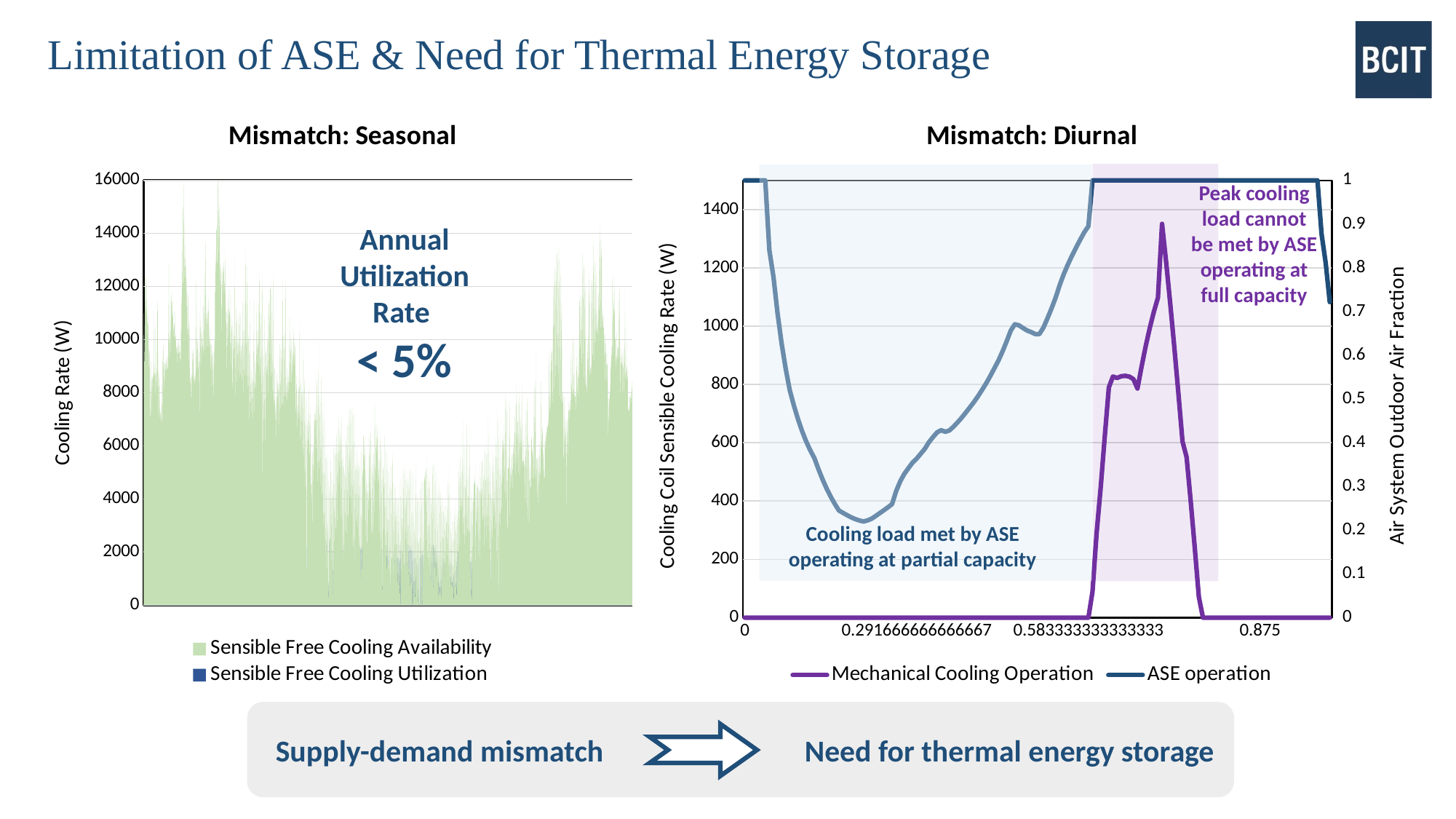
What kind of chart is the 'Mismatch: Seasonal' chart? area chart In the 'Mismatch: Seasonal' chart, which series has the larger values overall, Sensible Free Cooling Availability or Sensible Free Cooling Utilization? Sensible Free Cooling Availability According to the annotation on the 'Mismatch: Seasonal' chart, what is the Annual Utilization Rate? < 5% In the 'Mismatch: Diurnal' chart, is the lowest value of ASE operation greater or less than 0.3? less What kind of chart is the 'Mismatch: Diurnal' chart? line chart In the 'Mismatch: Diurnal' chart, does the ASE operation line rise or fall between x = 0 and x = 0.2916? fall What is the label of the left vertical axis of the 'Mismatch: Diurnal' chart? Cooling Coil Sensible Cooling Rate (W) How many series does the legend of the 'Mismatch: Seasonal' chart list? 2 In the 'Mismatch: Seasonal' chart, is the highest value of Sensible Free Cooling Availability greater or less than 12000? greater In the 'Mismatch: Diurnal' chart, which series is drawn in purple? Mechanical Cooling Operation In the 'Mismatch: Diurnal' chart, is the peak value of Mechanical Cooling Operation greater or less than 1200? greater How many series does the legend of the 'Mismatch: Diurnal' chart list? 2